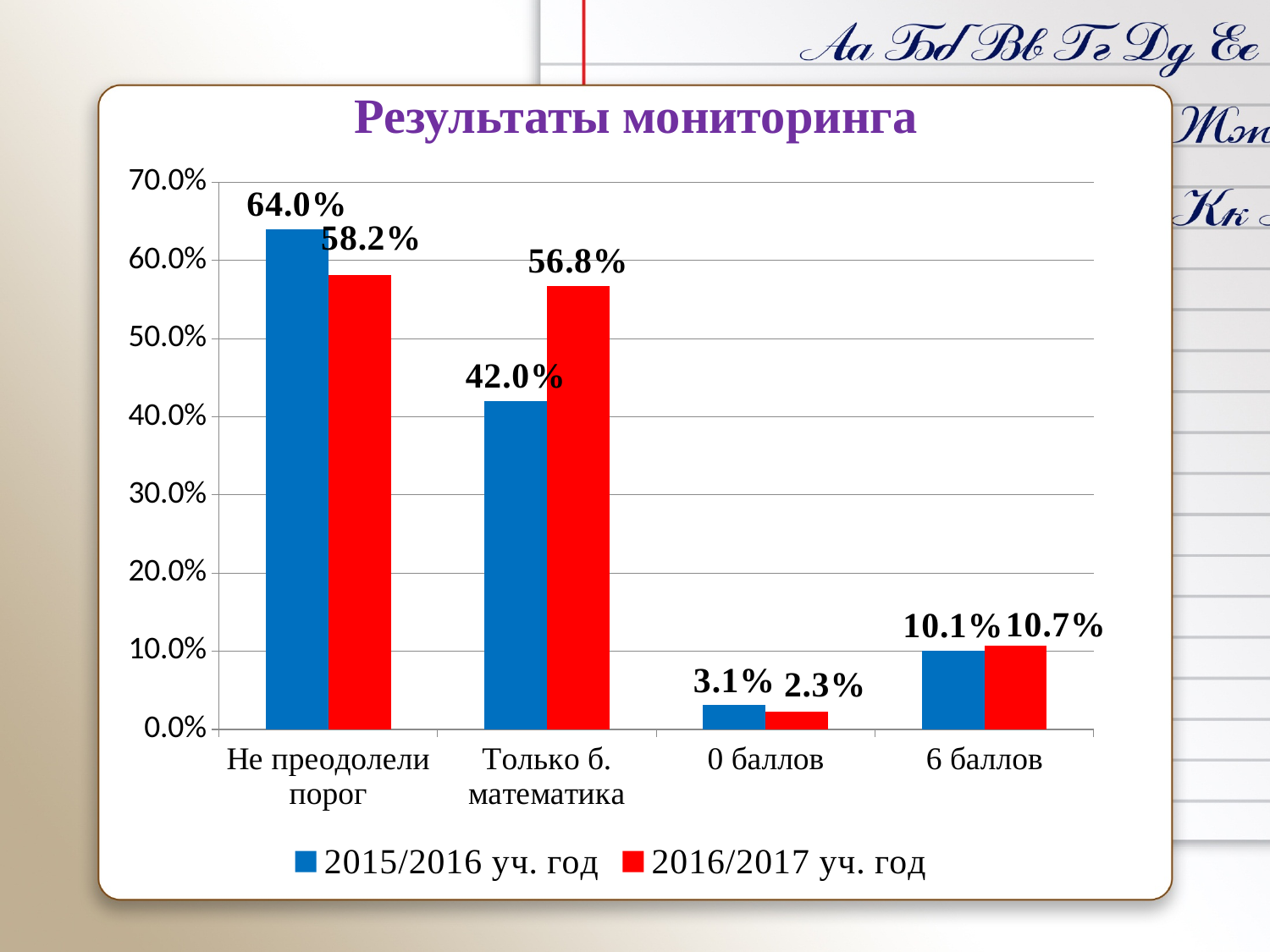
What is the title of the chart? Результаты мониторинга How many categories are shown on the x axis? 4 For '6 баллов', which series has the larger value, 2015/2016 уч. год or 2016/2017 уч. год? 2016/2017 уч. год What is the value for '6 баллов' in the 2015/2016 уч. год series? 10.1% What is the value for '0 баллов' in the 2016/2017 уч. год series? 2.3% What is the value for 'Только б. математика' in the 2016/2017 уч. год series? 56.8% Which category has the highest value in the 2015/2016 уч. год series? Не преодолели порог What is the value for 'Не преодолели порог' in the 2015/2016 уч. год series? 64.0% Which category has the lowest value in the 2016/2017 уч. год series? 0 баллов What is the difference between the 2015/2016 and 2016/2017 values for 'Только б. математика'? 14.8% What kind of chart is shown on the slide? Bar chart How many series does the legend list? 2